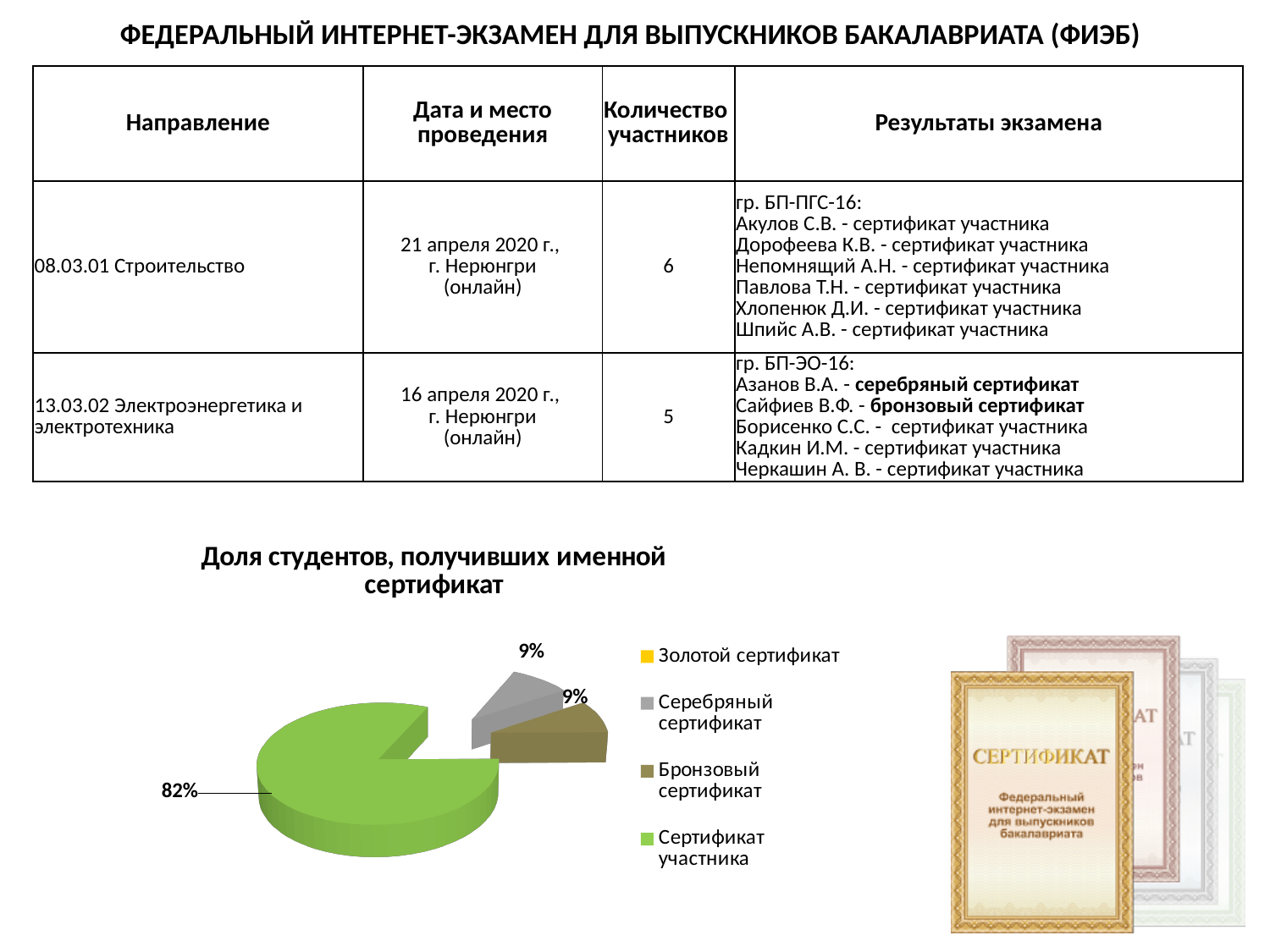
What share of the pie chart is labelled for Серебряный сертификат? 9% What is the title of the pie chart? Доля студентов, получивших именной сертификат What share of the pie chart is labelled for Сертификат участника? 82% Which slice is larger: Сертификат участника or Бронзовый сертификат? Сертификат участника What is the combined share of the Серебряный сертификат and Бронзовый сертификат slices? 18% What is the difference in percentage points between the Сертификат участника slice and the Серебряный сертификат slice? 73 What share of the pie chart is labelled for Бронзовый сертификат? 9% Is the share for Сертификат участника greater or less than 50%? greater Which category has the largest slice in the pie chart? Сертификат участника What kind of chart is shown on the slide? Pie chart What colour is the Сертификат участника slice in the pie chart? Green How many categories does the legend of the pie chart list? 4